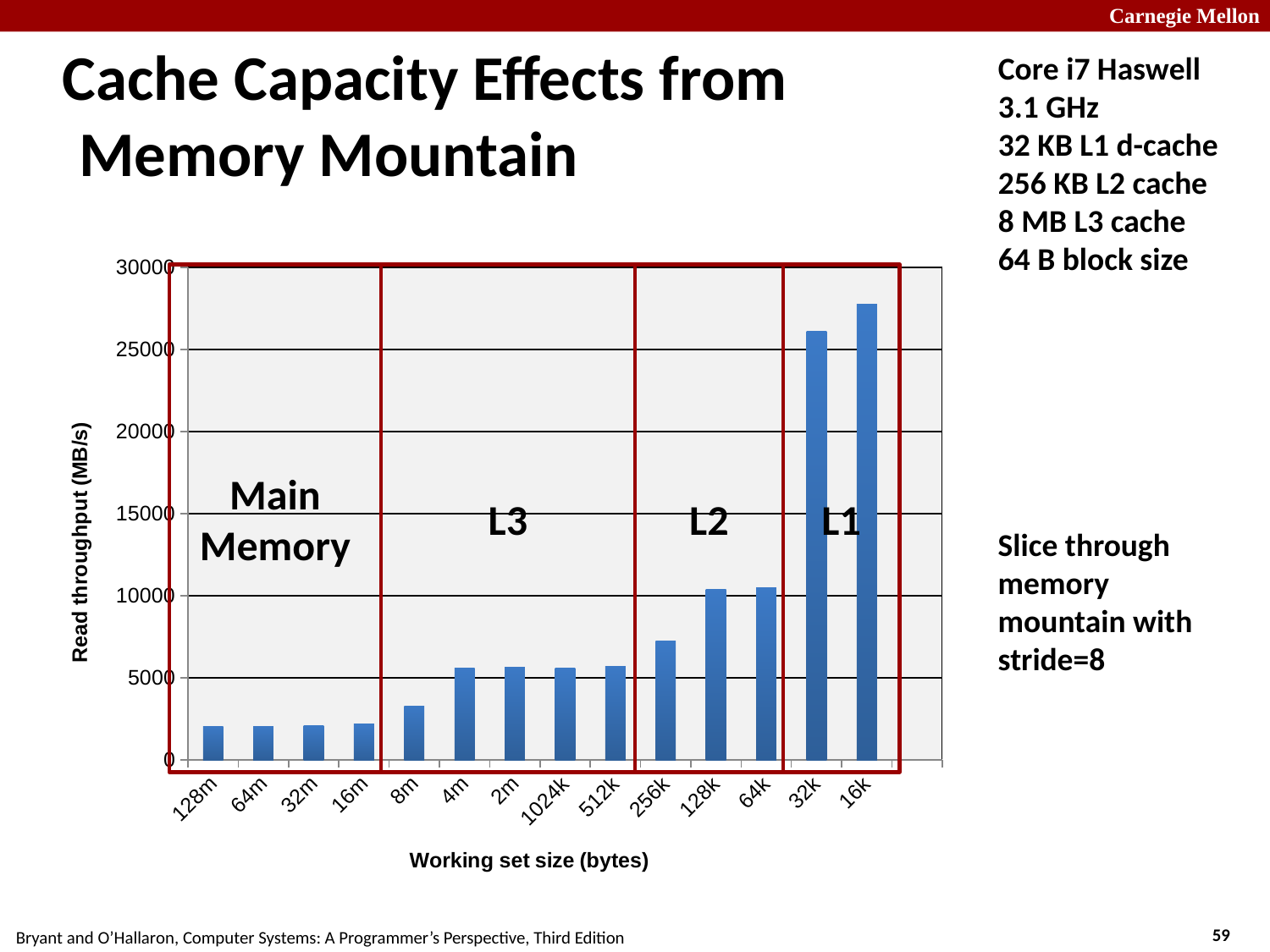
Is the read throughput for a working set size of 8m greater or less than 5000 MB/s? less Is the read throughput for a working set size of 128m greater or less than 5000 MB/s? less Is the read throughput for a working set size of 32k greater or less than 25000 MB/s? greater How many working set sizes are plotted along the x axis? 14 Which has the higher read throughput, a working set size of 16k or 32k? 16k Which working set size has the highest read throughput? 16k What kind of chart is shown on the slide? bar chart What is the label of the y axis? Read throughput (MB/s) Do the read throughput values generally rise or fall moving from left to right along the x axis? rise What is the label of the x axis? Working set size (bytes) Which has the higher read throughput, a working set size of 256k or 512k? 256k